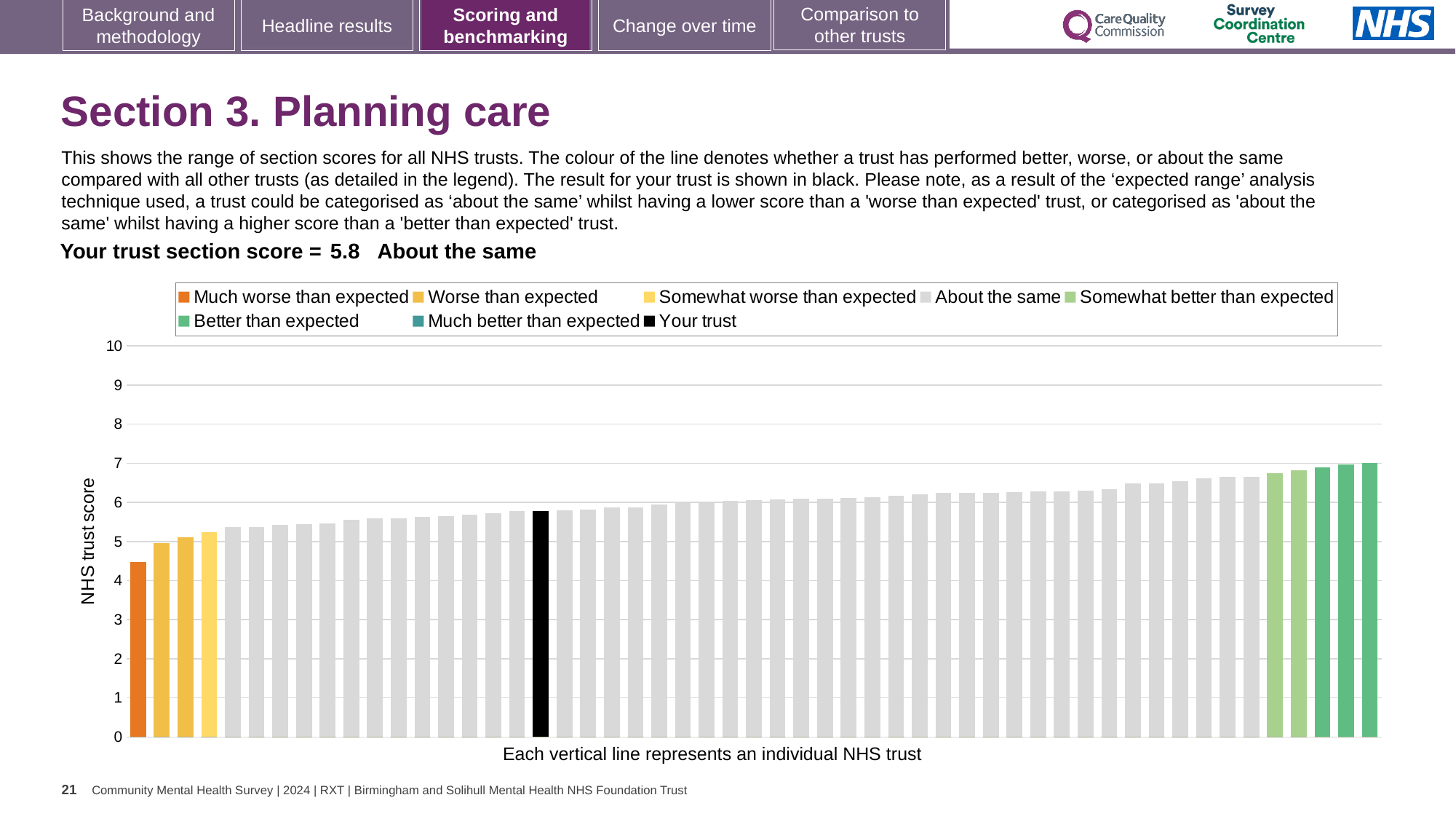
Do the bar values rise or fall from left to right along the x axis? rise Is the value of the highest (rightmost) bar greater or less than 6? greater What is the title of the vertical axis? NHS trust score Is the value for your trust greater or less than 5? greater What colour is used to show your trust in the chart? black Is the value of the lowest (leftmost) bar greater or less than 5? less How many entries does the chart legend list? 8 What kind of chart is shown on the slide? bar chart Which is larger: the value for your trust (black bar) or the value of the leftmost orange bar? your trust Which performance category is your trust placed in for Section 3 Planning care? About the same Which is larger: the value for your trust (black bar) or the value of the rightmost bar? the rightmost bar What is the section score for your trust shown on the slide? 5.8